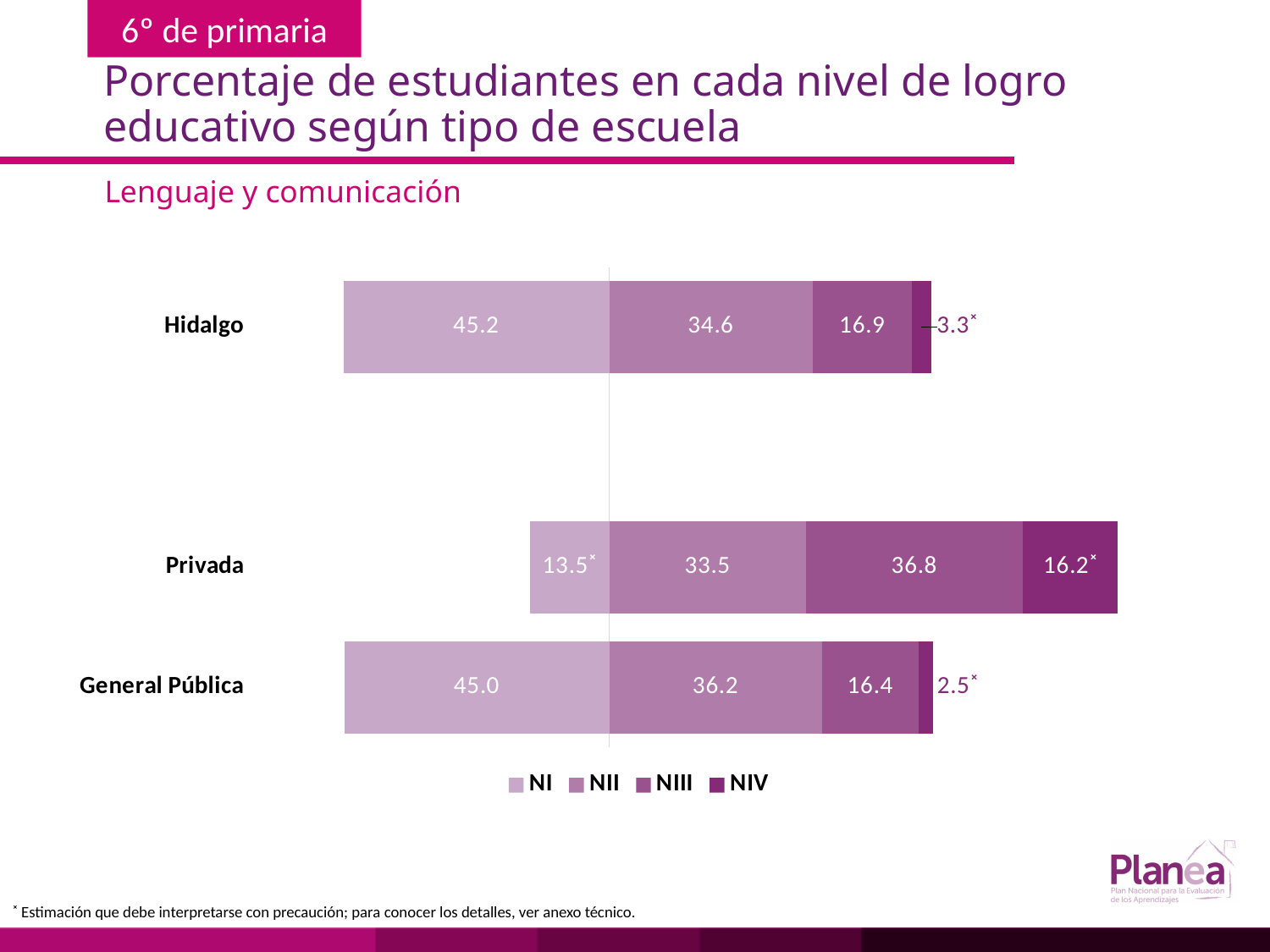
How many series does the legend list? 4 What is the value for NII in the Hidalgo bar? 34.6 What is the value for NIII in the Privada bar? 36.8 Which school type has the highest value for NIV? Privada What is the total of the Hidalgo stacked bar? 100.0 How many school-type categories are shown in the chart? 3 What is the difference between the NIII values for Privada and General Pública? 20.4 What kind of chart is shown on the slide? Stacked bar chart What percentage of Hidalgo students are at level NI in Lenguaje y comunicación? 45.2 Which is larger, the NII value for General Pública or the NII value for Hidalgo? General Pública What is the value for NIV in the General Pública bar? 2.5 Which school type has the lowest value for NI? Privada